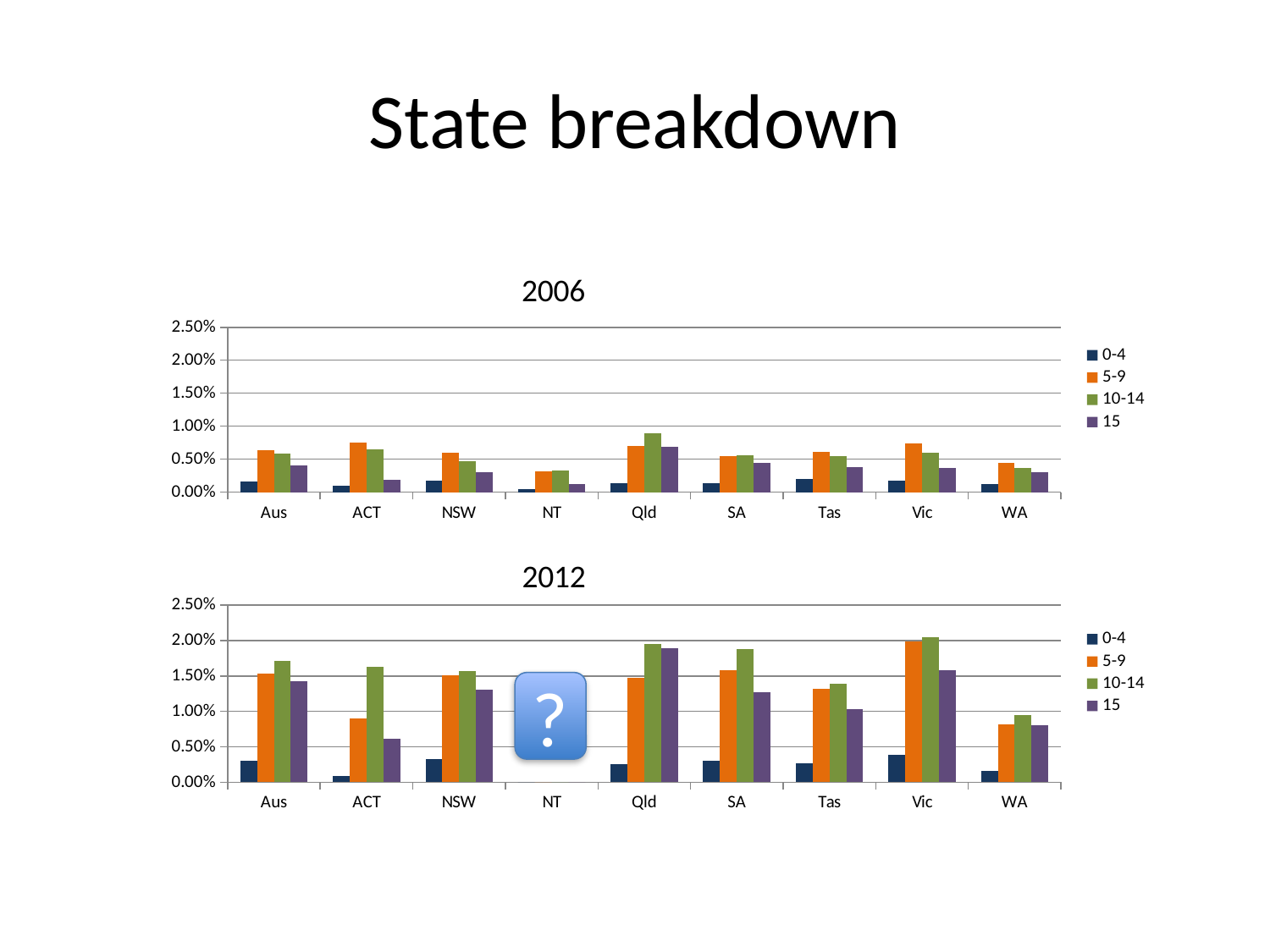
In the 2012 chart, which category has no bars plotted and is covered by a question mark? NT How many series does the legend of the 2012 chart list? 4 In the 2006 chart, which is larger: the 5-9 value for ACT or the 5-9 value for NSW? ACT In the 2012 chart, is the 15 value for ACT greater or less than 1.00%? less In the 2012 chart, is the 10-14 value for SA greater or less than 1.50%? greater In the 2012 chart, which is larger for Aus: the 5-9 value or the 10-14 value? 10-14 In the 2012 chart, which category has the highest 5-9 value? Vic In the 2006 chart, which category has the lowest 0-4 value? NT How many categories are shown on the x axis of the 2006 chart? 9 In the 2006 chart, is the 10-14 value for Qld greater or less than 0.50%? greater In the 2006 chart, which category has the highest 10-14 value? Qld What kind of chart is the 2006 chart? bar chart